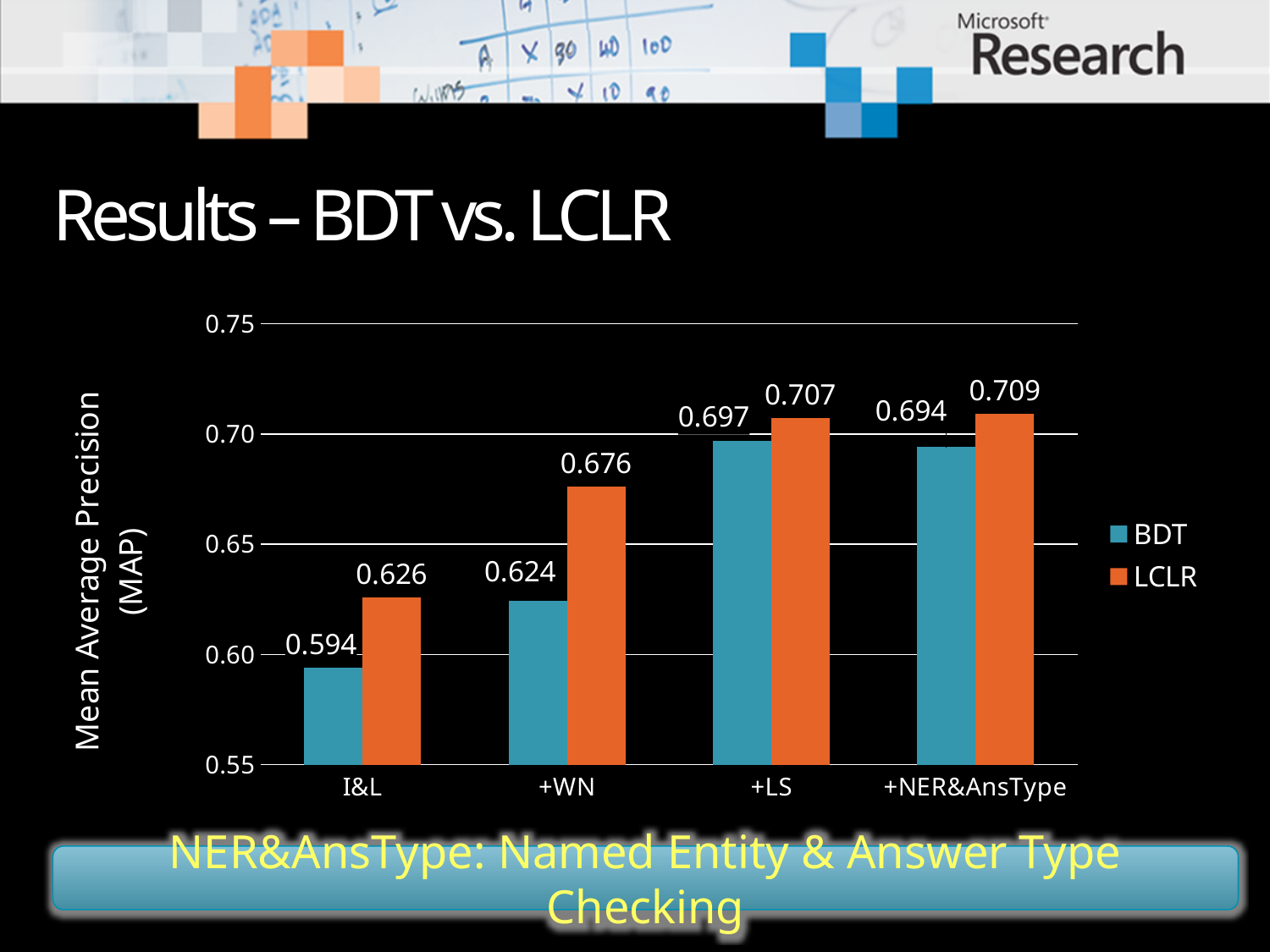
What is the LCLR value for +WN? 0.676 How many categories are shown on the x axis? 4 Which category has the highest LCLR value? +NER&AnsType How many series does the legend list? 2 What is the LCLR value for +NER&AnsType? 0.709 What is the BDT value for +LS? 0.697 Which is larger for I&L, the BDT value or the LCLR value? LCLR What is the difference between the LCLR and BDT values for +WN? 0.052 What is the label of the y axis? Mean Average Precision (MAP) What kind of chart is shown on the slide? bar chart What is the BDT value for I&L? 0.594 Which category has the lowest BDT value? I&L